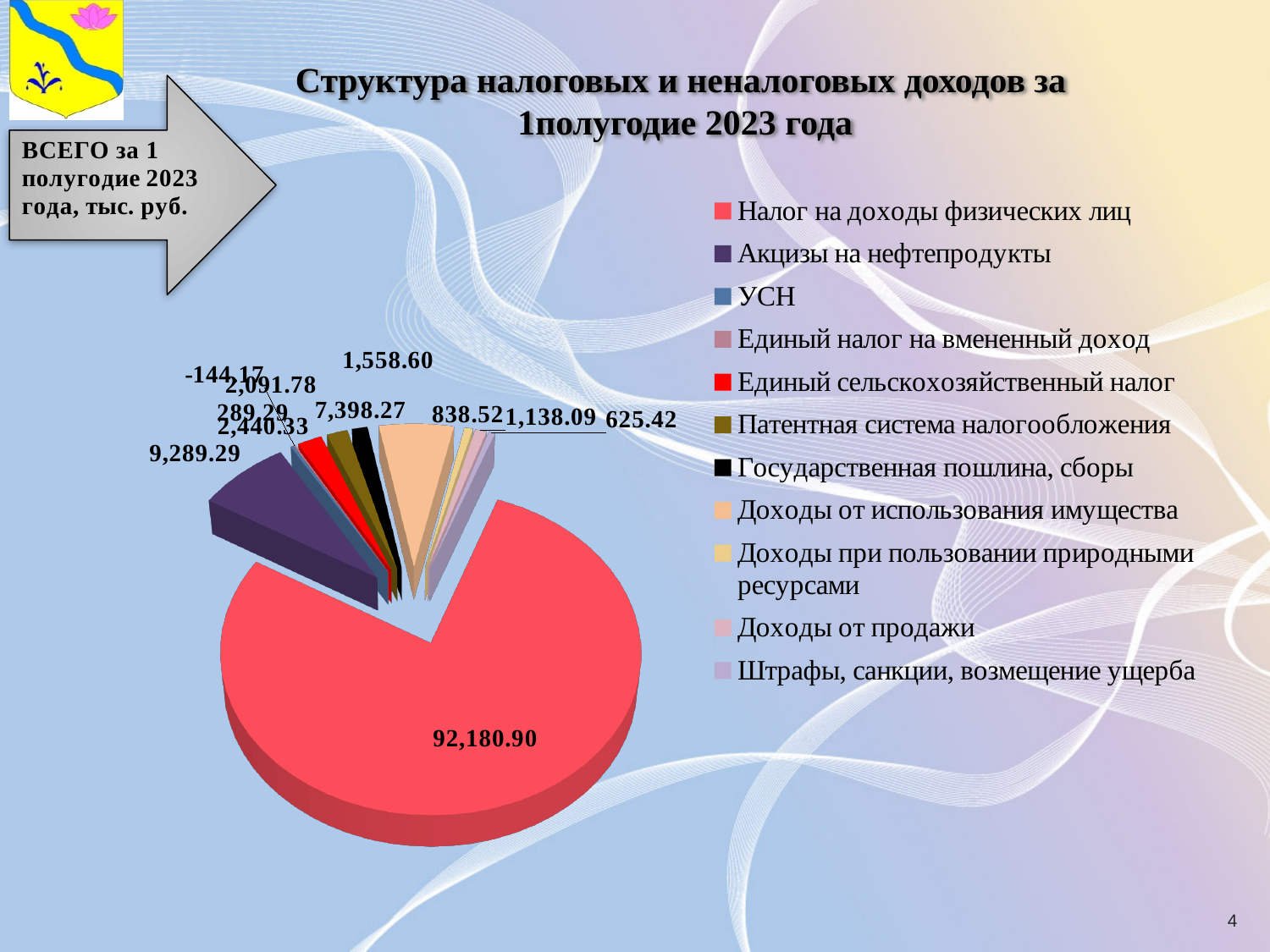
What is the difference between the values for Налог на доходы физических лиц and Акцизы на нефтепродукты? 82,891.61 Which is larger: Налог на доходы физических лиц or Акцизы на нефтепродукты? Налог на доходы физических лиц What is the value shown for Акцизы на нефтепродукты? 9,289.29 How many entries does the chart legend list? 11 In what units are the values on the chart given, according to the arrow box on the slide? тыс. руб. Which category has the largest slice of the pie? Налог на доходы физических лиц How many data labels are printed on the pie chart? 11 What is the title of the chart on the slide? Структура налоговых и неналоговых доходов за 1полугодие 2023 года What kind of chart is shown on the slide? Pie chart What is the value shown for Налог на доходы физических лиц? 92,180.90